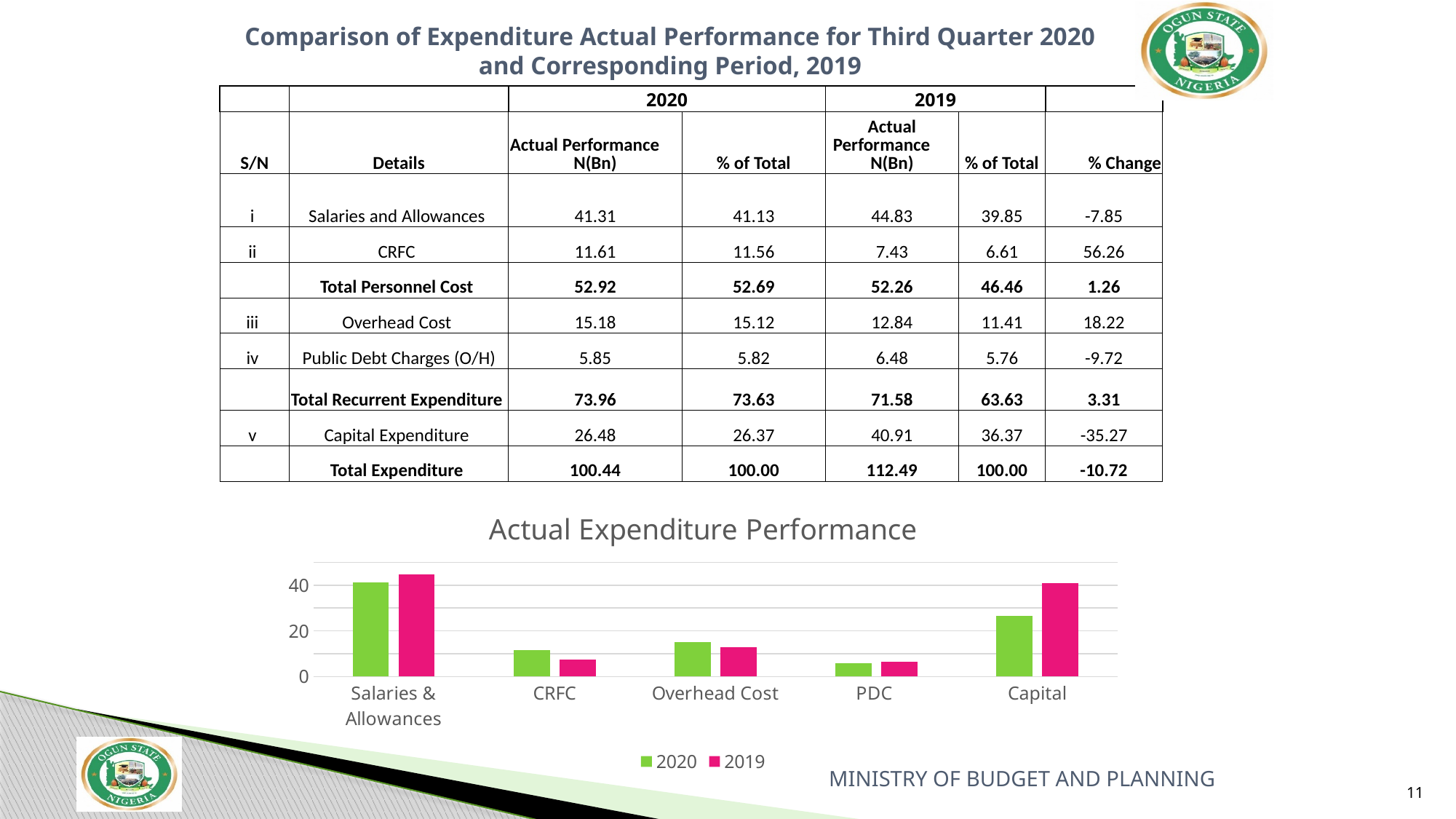
Which colour represents the 2019 series in the chart? pink Is the 2019 value for Salaries & Allowances greater or less than 40? greater Which category has the lowest 2020 bar in the chart? PDC Which category has the highest 2019 bar in the chart? Salaries & Allowances For Capital, is the 2020 bar or the 2019 bar taller? 2019 For CRFC, is the 2020 bar or the 2019 bar taller? 2020 What kind of chart is shown on the slide? bar chart What is the title of the chart? Actual Expenditure Performance How many series does the chart legend list? 2 How many categories are shown on the x axis of the chart? 5 Is the 2020 value for Overhead Cost greater or less than 20? less Which category has the highest 2020 bar in the chart? Salaries & Allowances